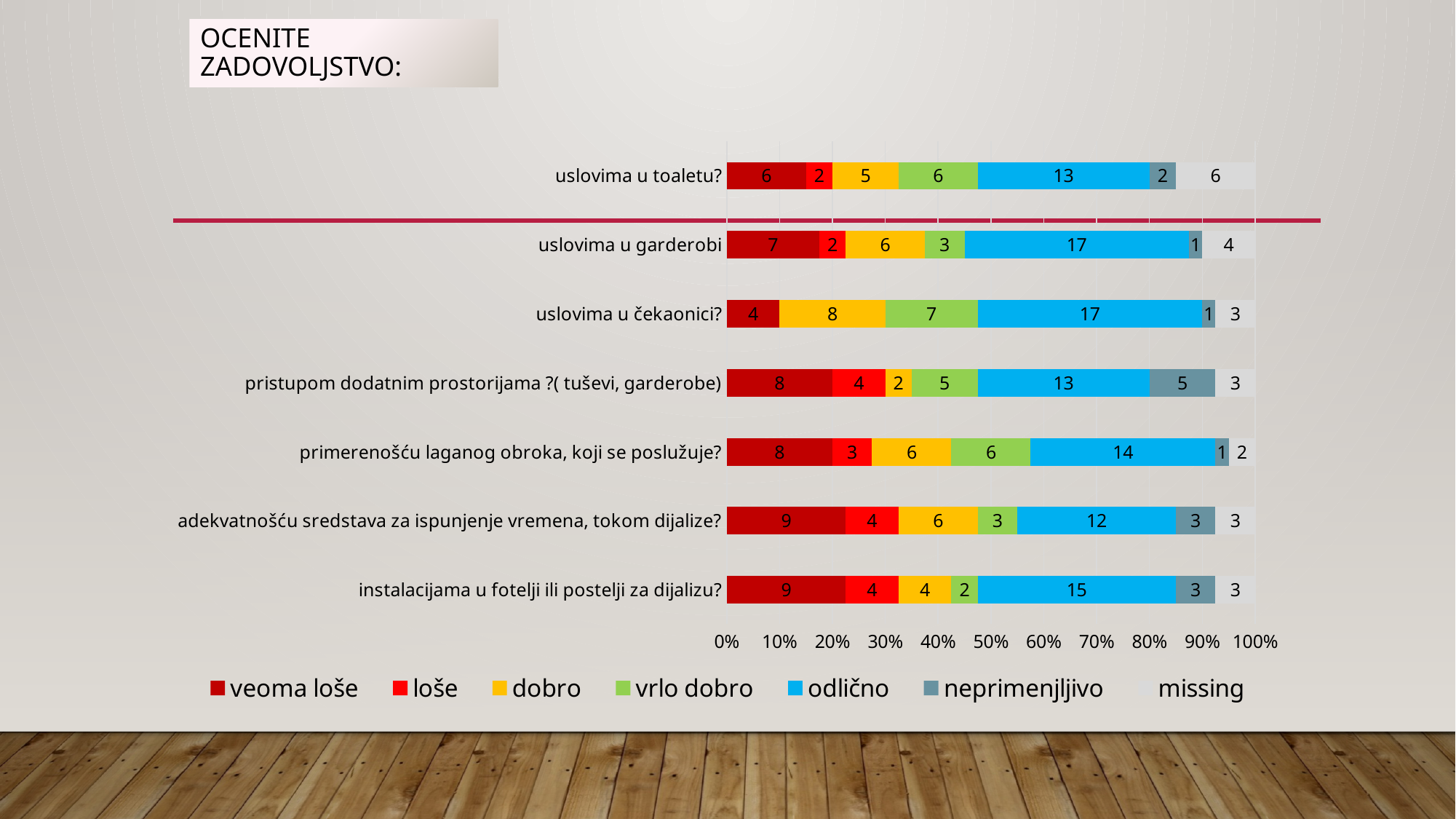
How many series does the legend list? 7 Which is larger: the "dobro" value for "uslovima u čekaonici?" or for "instalacijama u fotelji ili postelji za dijalizu?"? uslovima u čekaonici? What is the value of "missing" for "primerenošću laganog obroka, koji se poslužuje?"? 2 How many categories are shown on the chart? 7 Which category has the highest value for "veoma loše"? adekvatnošću sredstava za ispunjenje vremena, tokom dijalize? and instalacijama u fotelji ili postelji za dijalizu? (both 9) What is the value of "odlično" for "uslovima u garderobi"? 17 What is the difference between the "odlično" values for "uslovima u čekaonici?" and "uslovima u toaletu?"? 4 What is the value of "veoma loše" for "uslovima u toaletu?"? 6 What is the total of the stacked bar for "uslovima u toaletu?"? 40 What is the value of "neprimenjljivo" for "pristupom dodatnim prostorijama ?( tuševi, garderobe)"? 5 Which category has the lowest value for "odlično"? adekvatnošću sredstava za ispunjenje vremena, tokom dijalize? What kind of chart is shown on the slide? Stacked bar chart